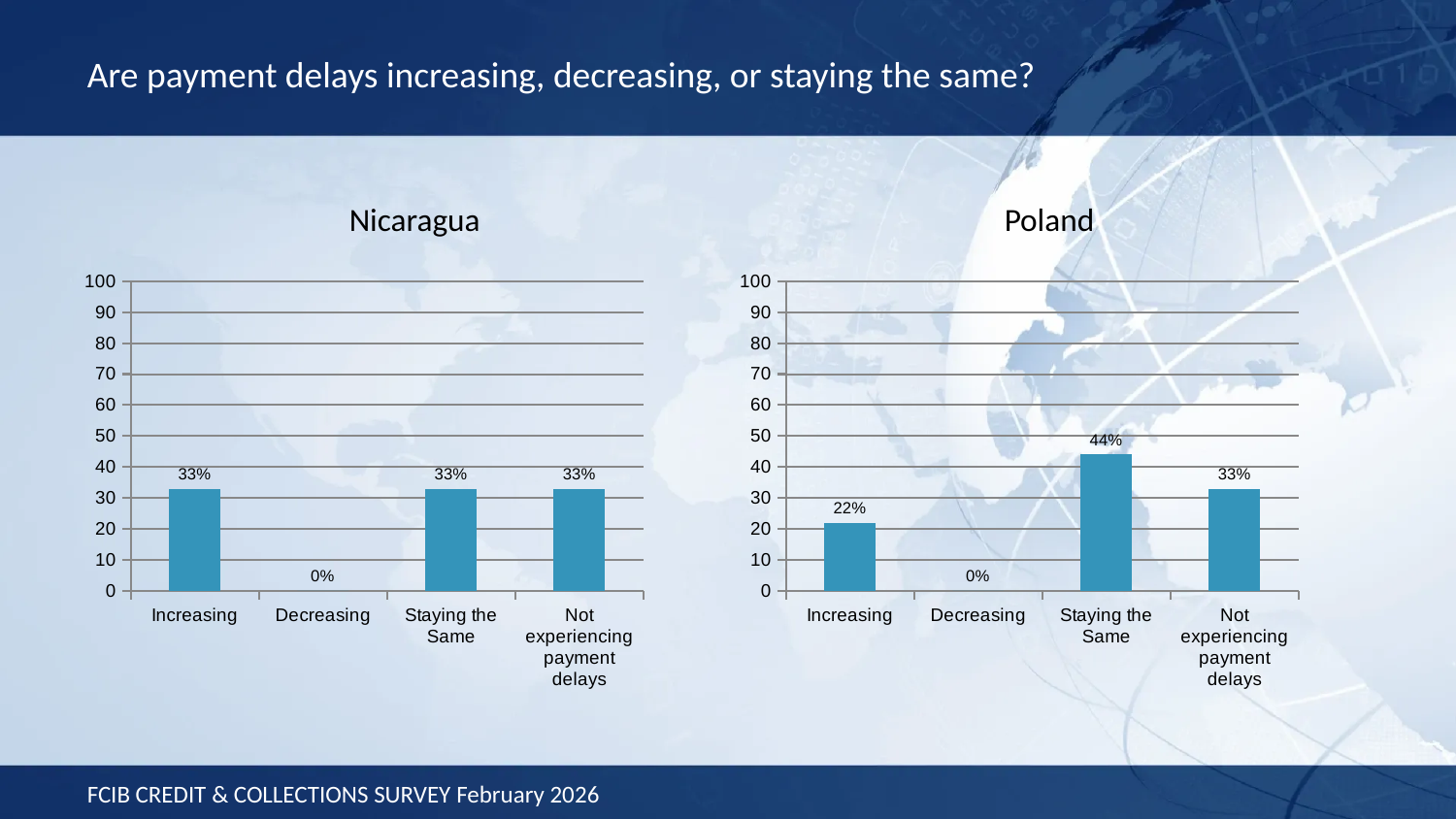
In the Poland chart, is the value for Staying the Same greater or less than 40? greater In the Poland chart, which category has the highest value? Staying the Same In the Poland chart, which is larger, Increasing or Not experiencing payment delays? Not experiencing payment delays How many categories are shown in the Nicaragua chart? 4 In the Nicaragua chart, what is the value for Increasing? 33% What kind of chart is the Poland chart? bar chart In the Nicaragua chart, what is the value for Decreasing? 0% In the Poland chart, what is the value for Increasing? 22% In the Poland chart, what is the difference between Staying the Same and Increasing? 22% What is the title of the chart on the left? Nicaragua In the Poland chart, what is the value for Staying the Same? 44% In the Poland chart, which category has the lowest value? Decreasing